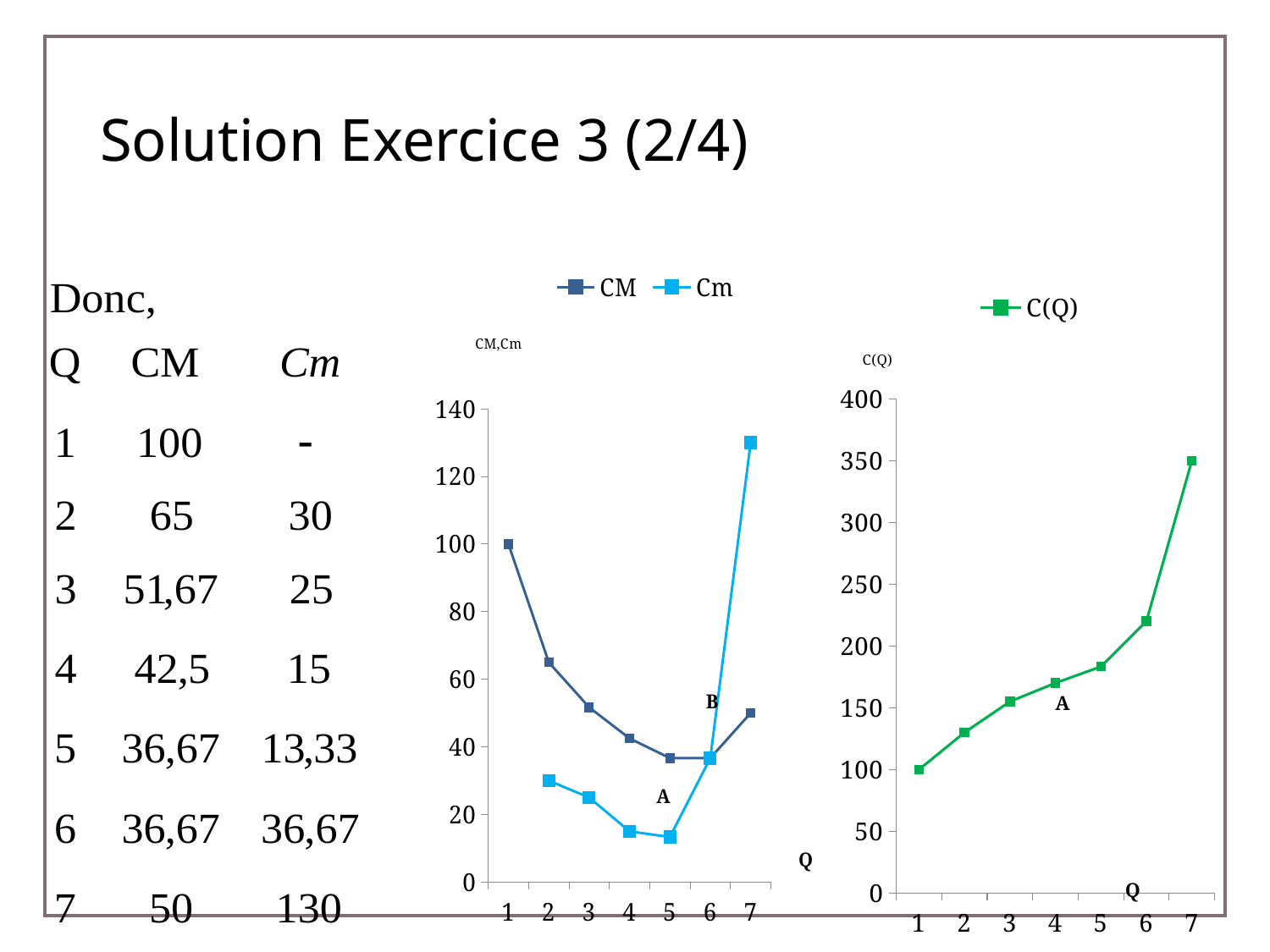
What kind of chart is the left chart (CM, Cm)? line chart In the left chart (CM, Cm), which is larger at Q = 2, CM or Cm? CM In the right chart (C(Q)), what is the value of C(Q) at Q = 7? 350 In the left chart (CM, Cm), at which Q is Cm highest? 7 In the right chart (C(Q)), do the values rise or fall as Q increases? rise In the left chart (CM, Cm), what is the value of CM at Q = 1? 100 In the right chart (C(Q)), what is the value of C(Q) at Q = 1? 100 How many series does the legend of the left chart (CM, Cm) list? 2 In the left chart (CM, Cm), is the value of Cm at Q = 7 greater or less than 120? greater In the left chart (CM, Cm), is the value of Cm at Q = 5 greater or less than 20? less In the right chart (C(Q)), is the value of C(Q) at Q = 6 greater or less than 200? greater How many data points are plotted in the right chart (C(Q))? 7